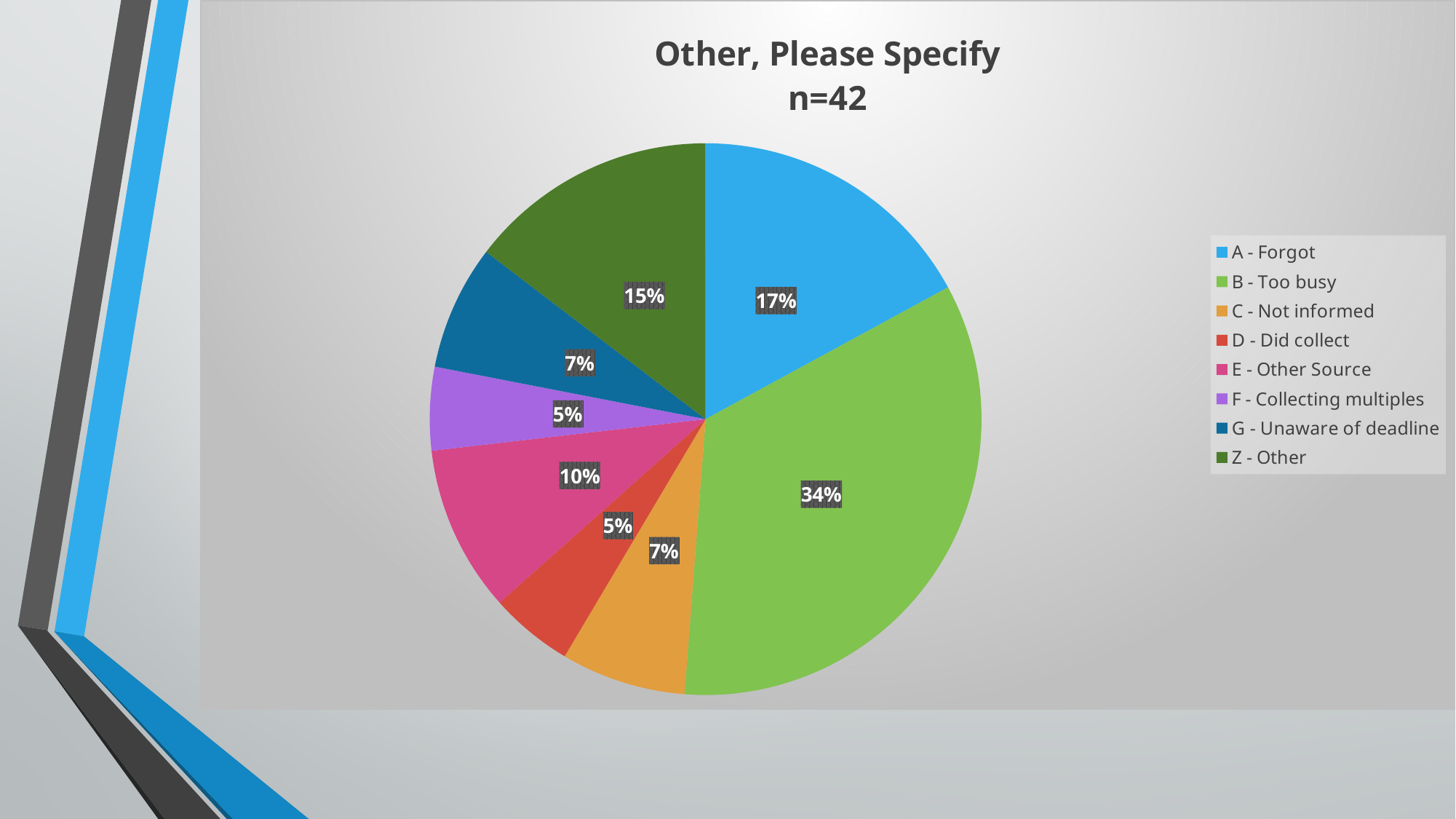
What is the sample size (n) stated in the chart title? 42 What is the title of the chart? Other, Please Specify n=42 What is the difference in percentage points between B - Too busy and A - Forgot? 17 Which category has the largest slice of the pie? B - Too busy Which is larger, the slice for Z - Other or the slice for E - Other Source? Z - Other What share of the pie does A - Forgot represent? 17% What share of the pie does B - Too busy represent? 34% What share of the pie does G - Unaware of deadline represent? 7% What type of chart is shown on the slide? Pie chart How many categories are shown in the pie chart? 8